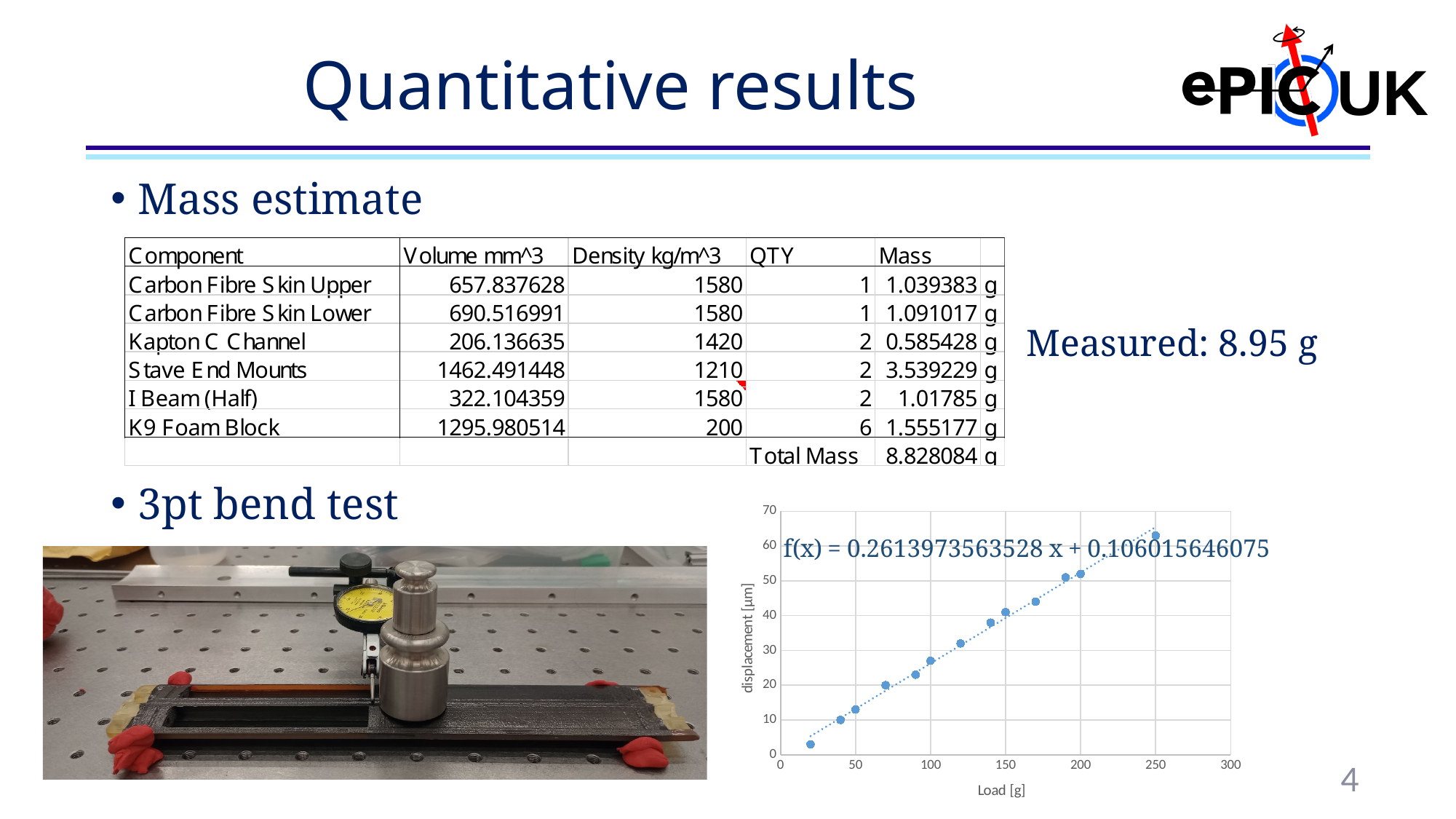
What is the highest tick value on the y axis of the 3pt bend test chart? 70 In the 3pt bend test chart, is the displacement at a load of 100 g greater or less than 30? less In the 3pt bend test chart, does displacement rise or fall as load increases? rise What kind of chart is shown in the 3pt bend test section? scatter chart In the 3pt bend test chart, is the displacement at a load of 250 g greater or less than 60? greater In the 3pt bend test chart, at which plotted load is the displacement highest? 250 In the 3pt bend test chart, at which plotted load is the displacement lowest? 20 In the 3pt bend test chart, which load gives the larger displacement, 150 g or 250 g? 250 g In the 3pt bend test chart, is the displacement at a load of 20 g greater or less than 10? less What is the label of the y axis in the 3pt bend test chart? displacement [μm] What is the trendline equation shown on the 3pt bend test chart? f(x) = 0.2613973563528 x + 0.106015646075